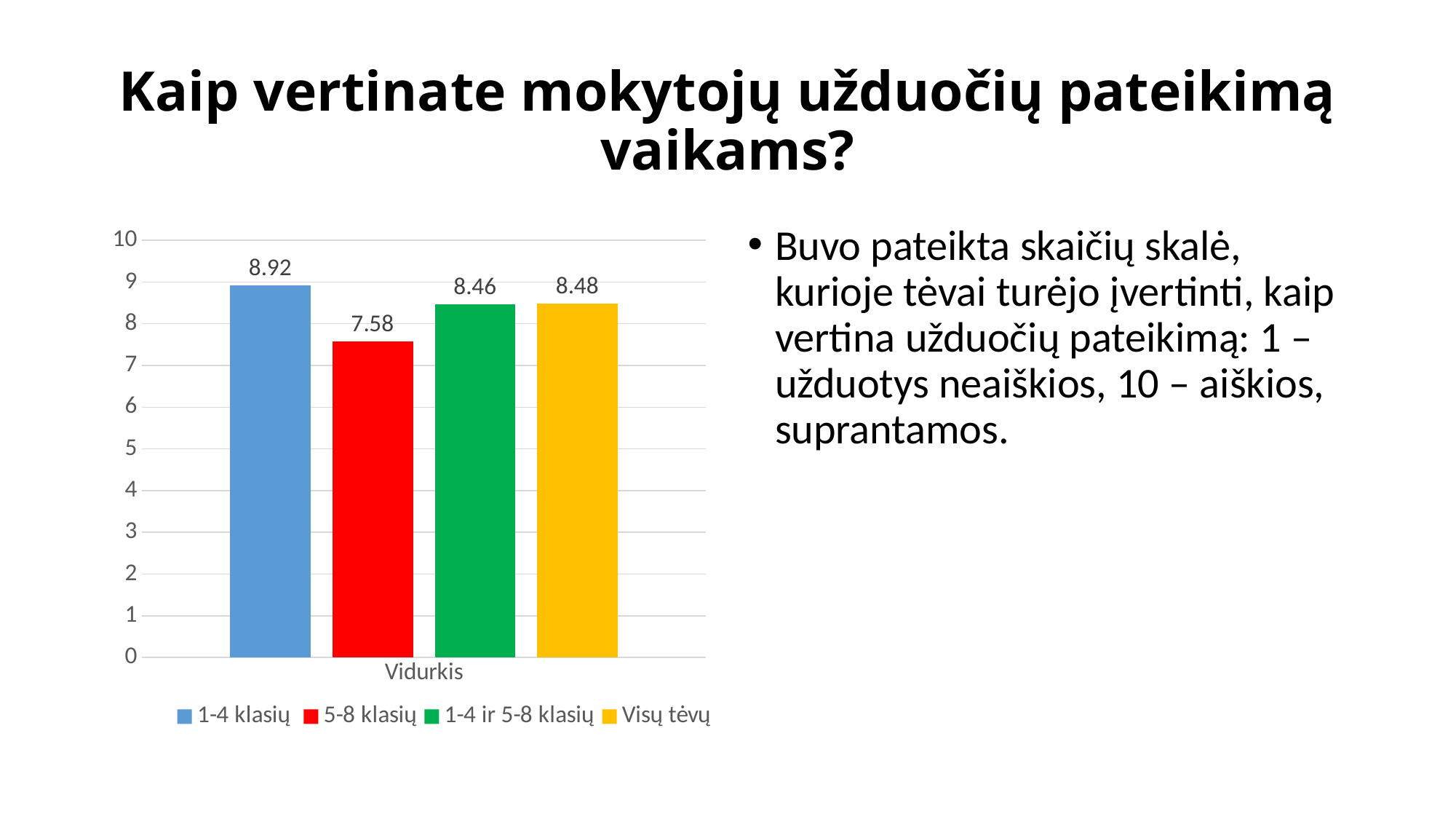
Which series has the lowest value? 5-8 klasių What is the value for 1-4 klasių? 8.92 What is the label on the x axis under the bars? Vidurkis What is the value for 5-8 klasių? 7.58 What is the difference between the values for 1-4 klasių and 5-8 klasių? 1.34 What kind of chart is shown on the slide? bar chart Which is larger, the value for 1-4 klasių or the value for 5-8 klasių? 1-4 klasių How many series does the legend list? 4 Which series has the highest value? 1-4 klasių What is the value for 1-4 ir 5-8 klasių? 8.46 What is the value for Visų tėvų? 8.48 Is the value for 5-8 klasių greater or less than 8? less